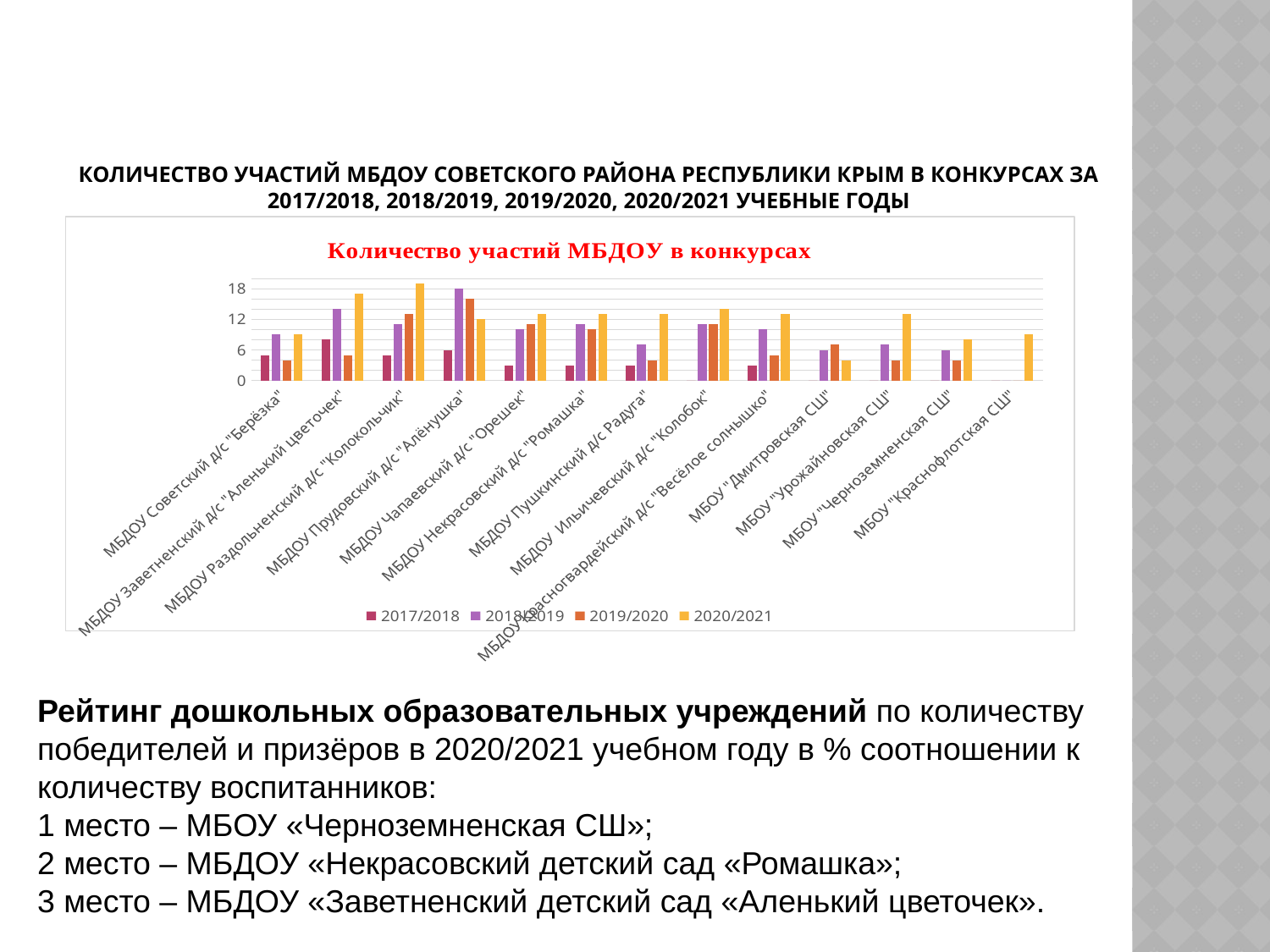
Which institution has the tallest 2020/2021 bar in the chart? МБДОУ Раздольненский д/с "Колокольчик" Which series is shown in yellow in the chart legend? 2020/2021 How many institutions (categories) are shown along the x axis of the chart? 13 Is the 2020/2021 value for МБДОУ Раздольненский д/с "Колокольчик" greater or less than 12? greater Is the 2018/2019 value for МБДОУ Прудовский д/с "Алёнушка" greater or less than 12? greater What kind of chart is shown on the slide? bar chart Is the 2020/2021 value for МБОУ "Краснофлотская СШ" greater or less than 12? less How many series does the legend of the chart list? 4 Which is larger: the 2017/2018 value for МБДОУ Прудовский д/с "Алёнушка" or the 2017/2018 value for МБДОУ Чапаевский д/с "Орешек"? МБДОУ Прудовский д/с "Алёнушка" What is the title printed inside the chart area? Количество участий МБДОУ в конкурсах Which is larger: the 2020/2021 value for МБОУ "Черноземненская СШ" or the 2020/2021 value for МБОУ "Урожайновская СШ"? МБОУ "Урожайновская СШ"